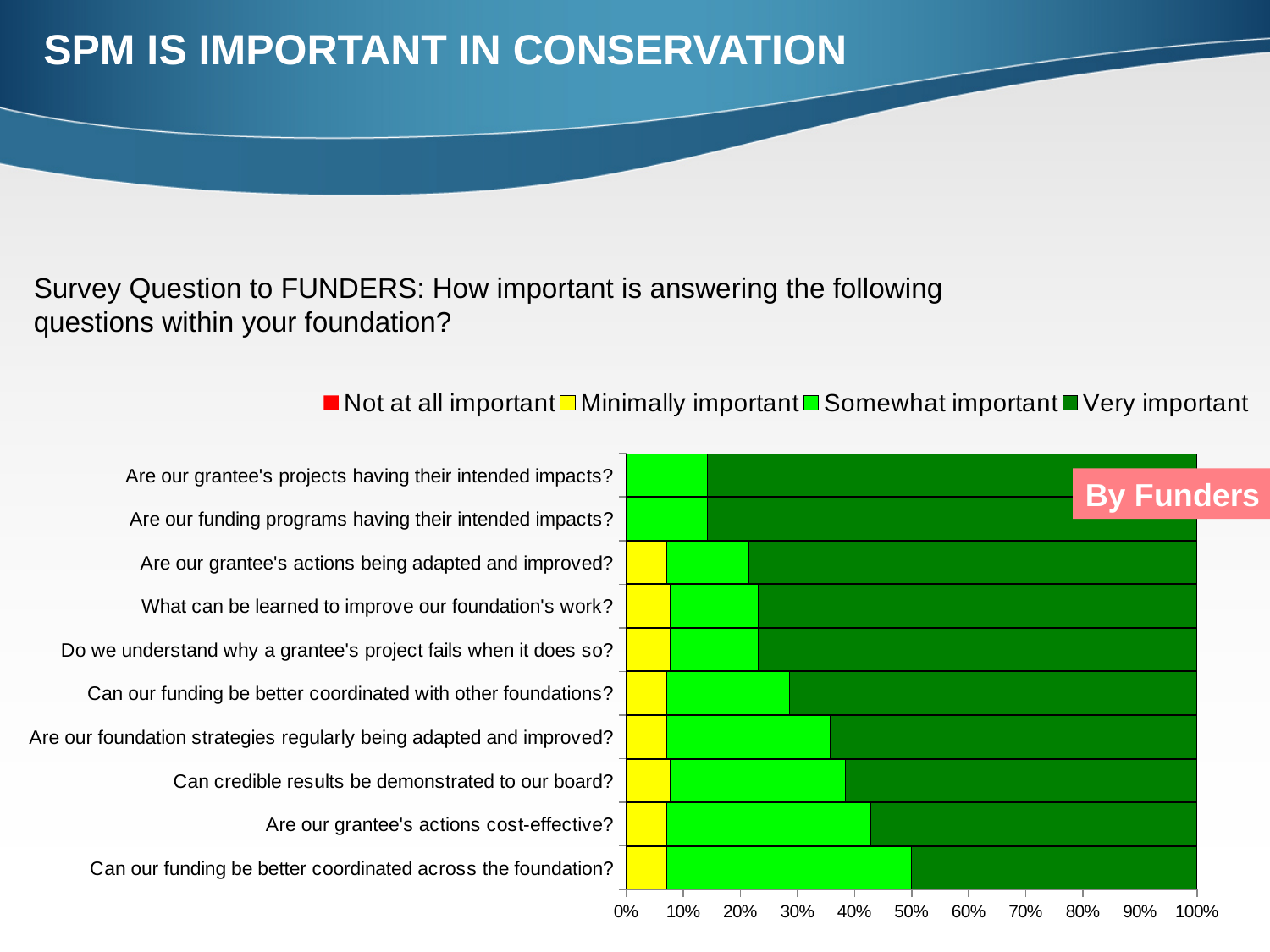
Which category has the largest 'Somewhat important' share? Can our funding be better coordinated across the foundation? How many series does the chart legend list? 4 Which category has the smallest 'Very important' share? Can our funding be better coordinated across the foundation? Is the 'Very important' share for 'Are our grantee's actions cost-effective?' greater or less than 50%? greater What kind of chart is shown on the slide? Stacked bar chart What are the four response categories listed in the legend? Not at all important, Minimally important, Somewhat important, Very important How many categories show a 'Minimally important' (yellow) segment? 8 Which has the larger 'Very important' share: 'Can credible results be demonstrated to our board?' or 'Are our grantee's actions being adapted and improved?' Are our grantee's actions being adapted and improved? Is the 'Somewhat important' share for 'Can our funding be better coordinated across the foundation?' greater or less than 30%? greater What label appears in the pink box on the chart? By Funders How many survey questions (categories) are plotted on the chart? 10 Is the 'Very important' share for 'Are our grantee's projects having their intended impacts?' greater or less than 80%? greater